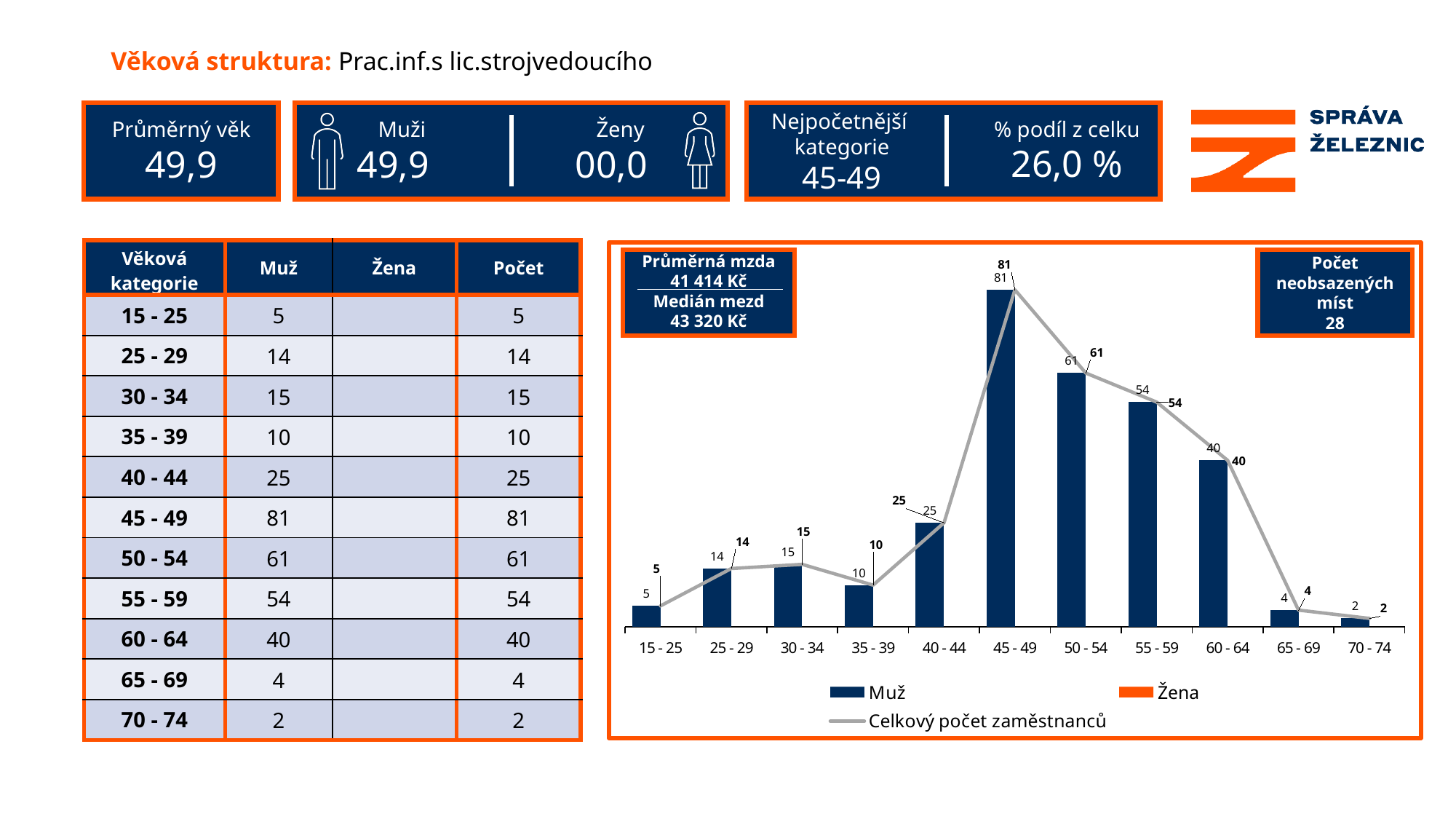
What kind of chart is shown on the slide? Combined bar and line chart Which age category has the highest Muž bar? 45 - 49 What is the value of the Celkový počet zaměstnanců line at the 40 - 44 age category? 25 What is the value of the Muž bar for the 60 - 64 age category? 40 Which is larger, the Muž value for 25 - 29 or for 30 - 34? 30 - 34 Do the Muž values rise or fall from the 45 - 49 category to the 70 - 74 category? Fall Which age category has the lowest Muž bar? 70 - 74 What is the difference between the Muž values for 45 - 49 and 50 - 54? 20 What is the value of the Muž bar for the 45 - 49 age category? 81 What colour are the Muž bars in the chart? Dark blue How many series does the chart legend list? 3 How many age categories are shown on the x axis of the chart? 11